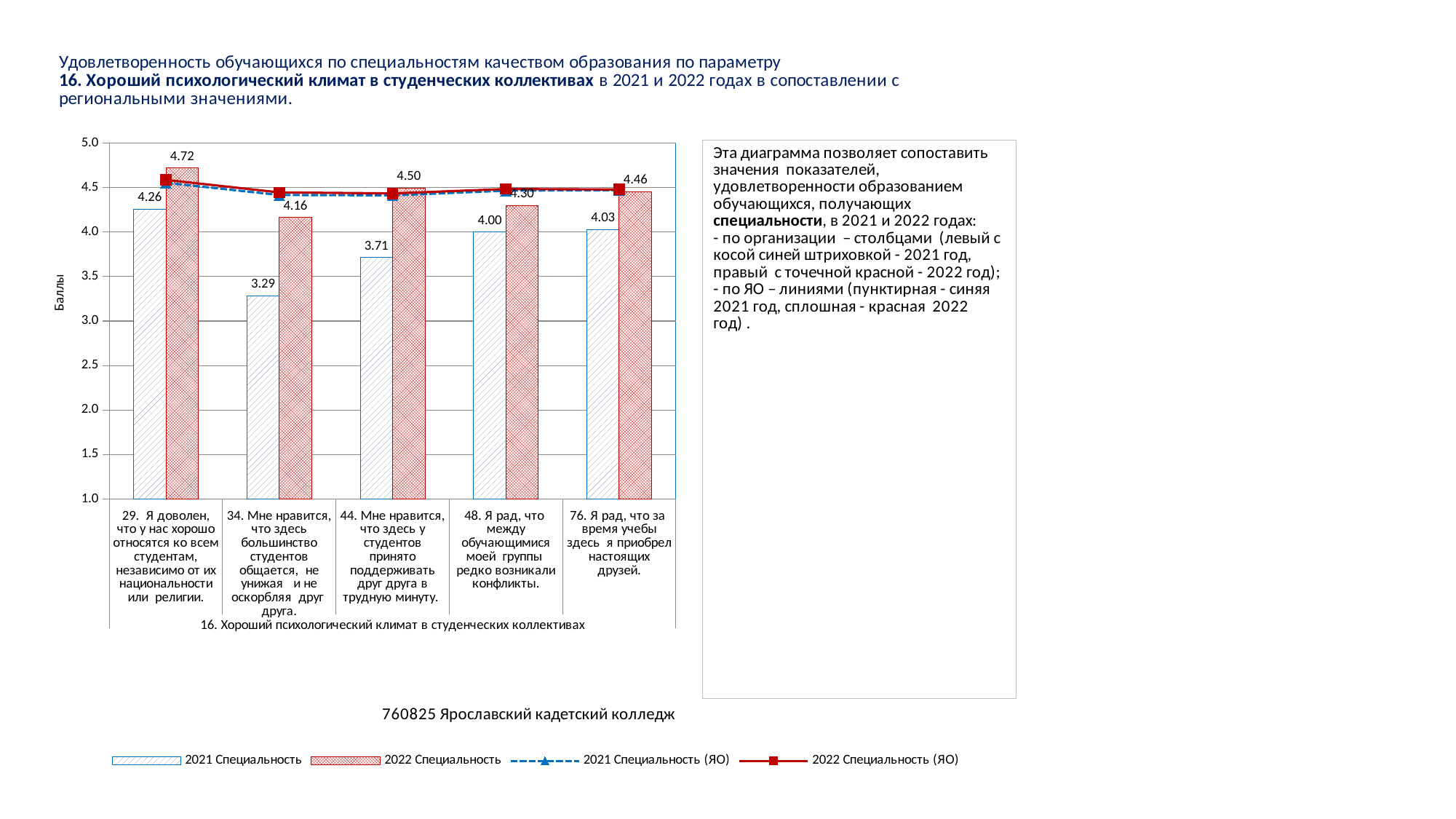
Is the 2022 Специальность (ЯО) line value for item 34 greater or less than 4.0? greater What is the difference between the 2022 and 2021 Специальность values for item 44 (Мне нравится, что здесь у студентов принято поддерживать друг друга в трудную минуту)? 0.79 What is the 2021 Специальность value for item 34 (Мне нравится, что здесь большинство студентов общается, не унижая и не оскорбляя друг друга)? 3.29 Which item has the highest 2022 Специальность value? 29. Я доволен, что у нас хорошо относятся ко всем студентам, независимо от их национальности или религии. Which is larger for item 76 (Я рад, что за время учебы здесь я приобрел настоящих друзей): the 2021 Специальность value or the 2022 Специальность value? 2022 Специальность What is the 2022 Специальность value for item 29 (Я доволен, что у нас хорошо относятся ко всем студентам)? 4.72 Which item has the lowest 2021 Специальность value? 34. Мне нравится, что здесь большинство студентов общается, не унижая и не оскорбляя друг друга. What is the label of the vertical axis? Баллы How many series does the legend list? 4 What kind of chart is shown on the slide? Combined bar and line chart How many items (categories) are shown on the x axis? 5 What is the 2022 Специальность value for item 48 (Я рад, что между обучающимися моей группы редко возникали конфликты)? 4.30